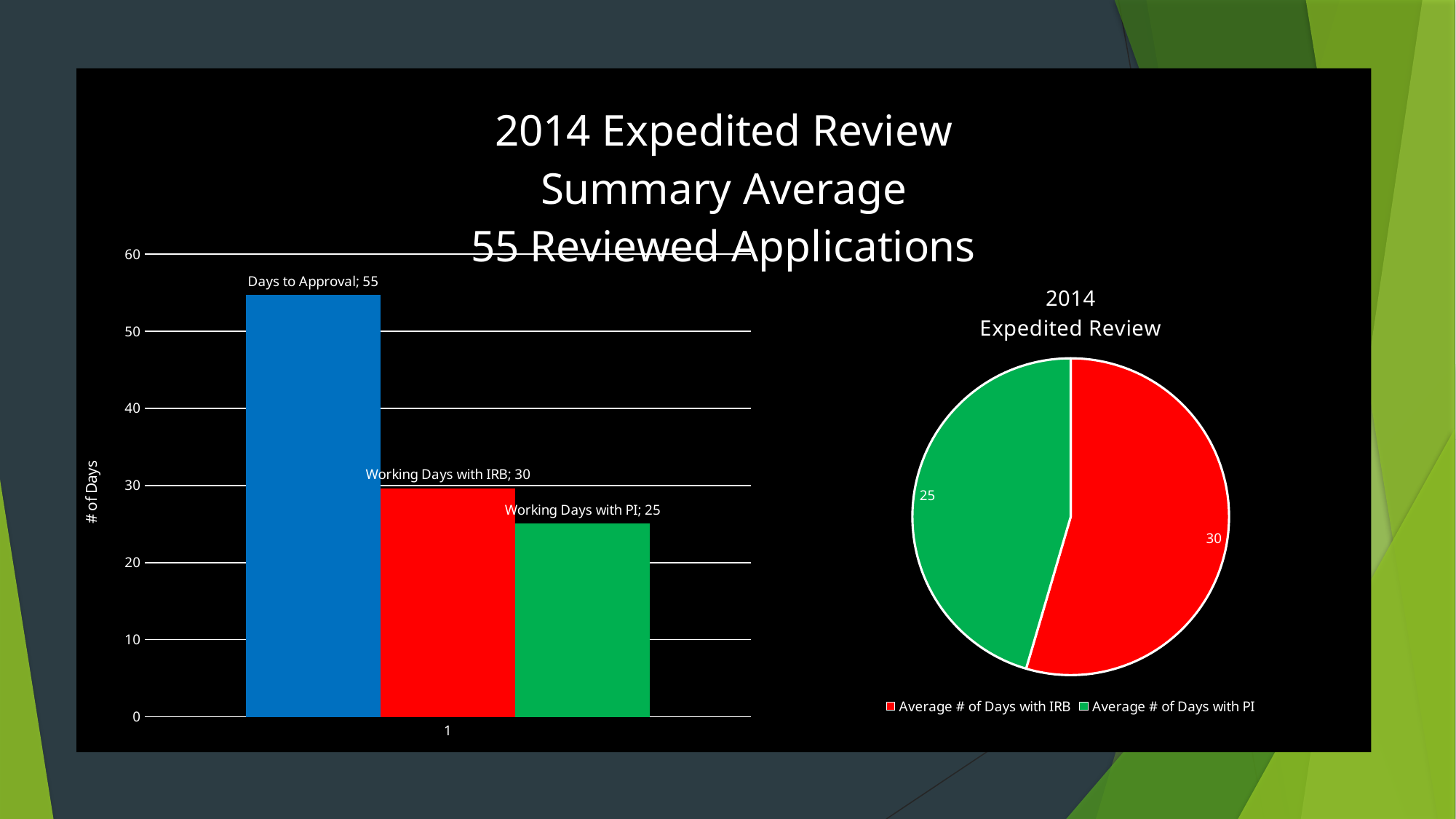
In the pie chart on the right, what is the value for Average # of Days with IRB? 30 In the pie chart on the right, how many series does the legend list? 2 What is the y-axis label of the bar chart on the left? # of Days In the bar chart on the left, what is the value for Days to Approval? 55 In the bar chart on the left, what is the value for Working Days with PI? 25 What kind of chart is the '2014 Expedited Review' chart on the right? pie chart In the bar chart on the left, what is the value for Working Days with IRB? 30 In the bar chart on the left, what is the difference between Days to Approval and Working Days with IRB? 25 In the bar chart on the left, which is larger: Working Days with IRB or Working Days with PI? Working Days with IRB In the bar chart on the left, which series has the highest value? Days to Approval What kind of chart is the chart on the left? bar chart In the bar chart on the left, which series has the lowest value? Working Days with PI